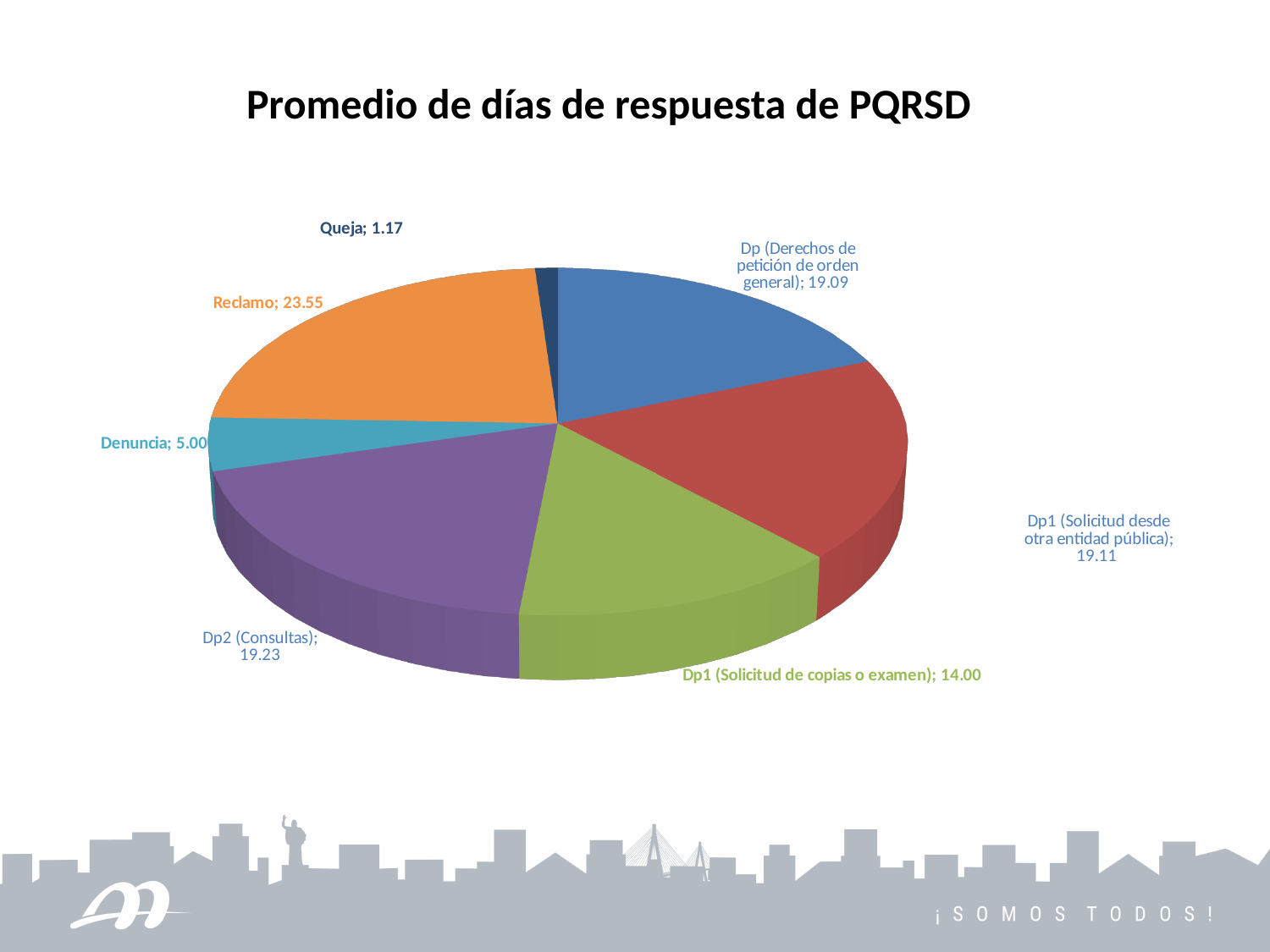
What is the difference between the values for Dp (Derechos de petición de orden general) and Queja? 17.92 What is the value for Dp2 (Consultas)? 19.23 How many categories (slices) does the pie chart have? 7 What is the value for Reclamo? 23.55 Which category has the lowest value? Queja Which is larger, the value for Reclamo or the value for Dp1 (Solicitud de copias o examen)? Reclamo What is the difference between the values for Reclamo and Denuncia? 18.55 What is the value for Denuncia? 5.00 What type of chart is shown on the slide? Pie chart What is the value for Dp1 (Solicitud de copias o examen)? 14.00 What is the title of the chart? Promedio de días de respuesta de PQRSD Which category has the highest value? Reclamo